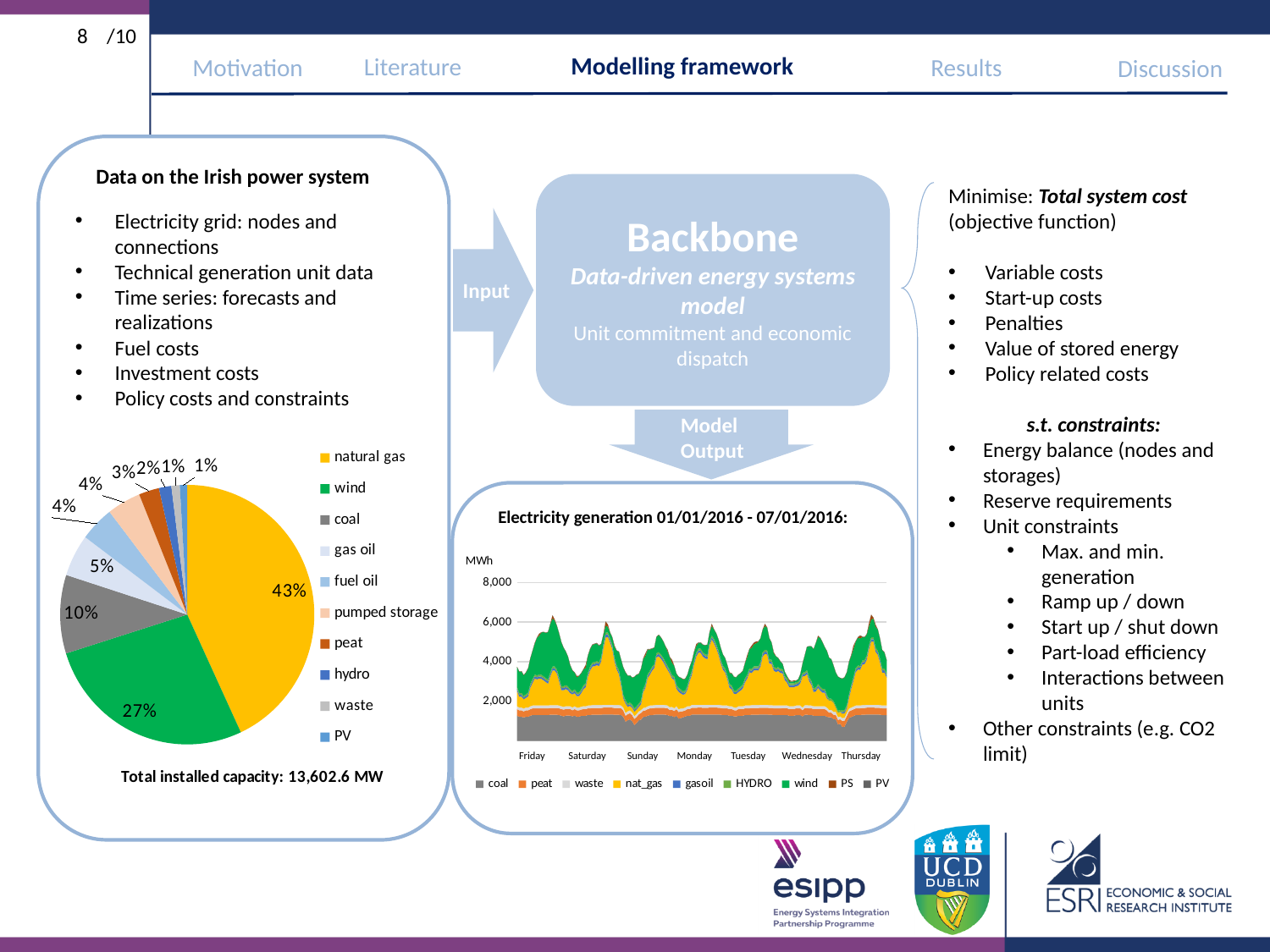
In the pie chart on the left, what share of installed capacity is wind? 27% How many series does the legend of the 'Electricity generation 01/01/2016 - 07/01/2016' chart list? 9 In the pie chart on the left, what is the difference in percentage points between the natural gas share and the wind share? 16% In the pie chart on the left, what share of installed capacity is natural gas? 43% In the pie chart on the left, which category has the largest share? natural gas What kind of chart is the 'Electricity generation 01/01/2016 - 07/01/2016' chart? stacked area chart In the pie chart on the left, which is larger, the share for coal or the share for gas oil? coal In the 'Electricity generation 01/01/2016 - 07/01/2016' chart, is the peak total generation greater or less than 8,000 MWh? less In the pie chart on the left, what share of installed capacity is coal? 10% How many days are labelled on the x axis of the 'Electricity generation 01/01/2016 - 07/01/2016' chart? 7 How many categories does the legend of the pie chart on the left list? 10 What total installed capacity is stated below the pie chart on the left? 13,602.6 MW